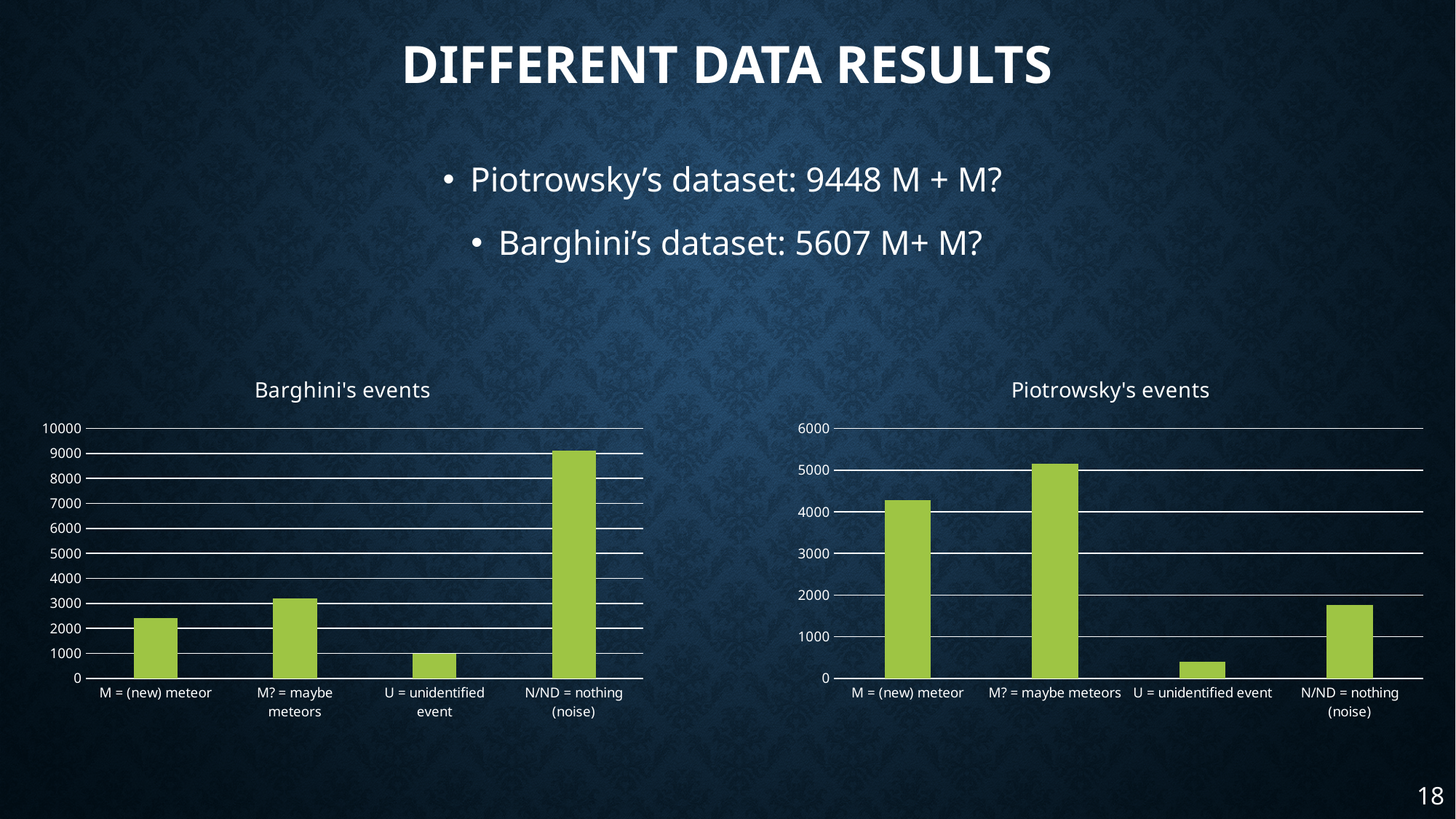
How many categories are shown in the "Barghini's events" chart? 4 In the "Piotrowsky's events" chart, is the value for N/ND = nothing (noise) greater or less than 2000? less In the "Piotrowsky's events" chart, which category has the lowest value? U = unidentified event What kind of chart is the "Barghini's events" chart? bar chart In the "Barghini's events" chart, which category has the lowest value? U = unidentified event In the "Piotrowsky's events" chart, which category has the highest value? M? = maybe meteors In the "Barghini's events" chart, is the value for M = (new) meteor greater or less than 3000? less In the "Piotrowsky's events" chart, is the value for M = (new) meteor greater or less than 4000? greater What is the title of the chart on the right side of the slide? Piotrowsky's events In the "Barghini's events" chart, which category has the highest value? N/ND = nothing (noise)